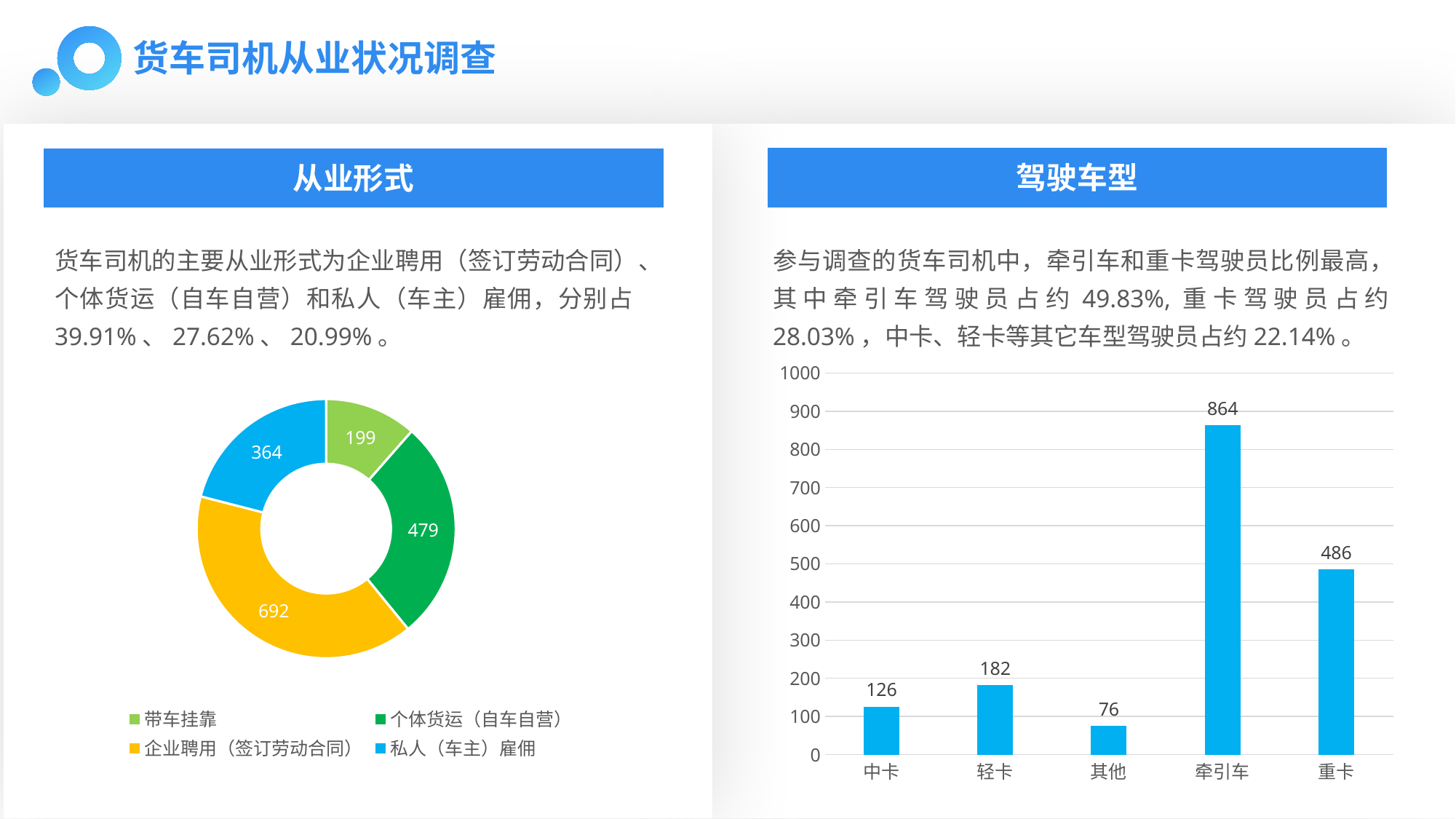
In the 驾驶车型 chart, what is the difference between 牵引车 and 重卡? 378 In the 从业形式 donut chart, what is the value for 带车挂靠? 199 In the 从业形式 donut chart, what share of the total does 企业聘用（签订劳动合同） represent? 39.91% How many categories does the legend of the 从业形式 chart list? 4 What kind of chart is the 驾驶车型 chart? bar chart How many categories are shown on the x axis of the 驾驶车型 chart? 5 In the 驾驶车型 chart, what is the value for 牵引车? 864 In the 从业形式 donut chart, which category has the largest value? 企业聘用（签订劳动合同） In the 从业形式 donut chart, what is the value for 企业聘用（签订劳动合同）? 692 In the 驾驶车型 chart, which category has the lowest value? 其他 In the 驾驶车型 chart, which is larger, 中卡 or 轻卡? 轻卡 In the 从业形式 donut chart, what is the difference between 个体货运（自车自营） and 私人（车主）雇佣? 115